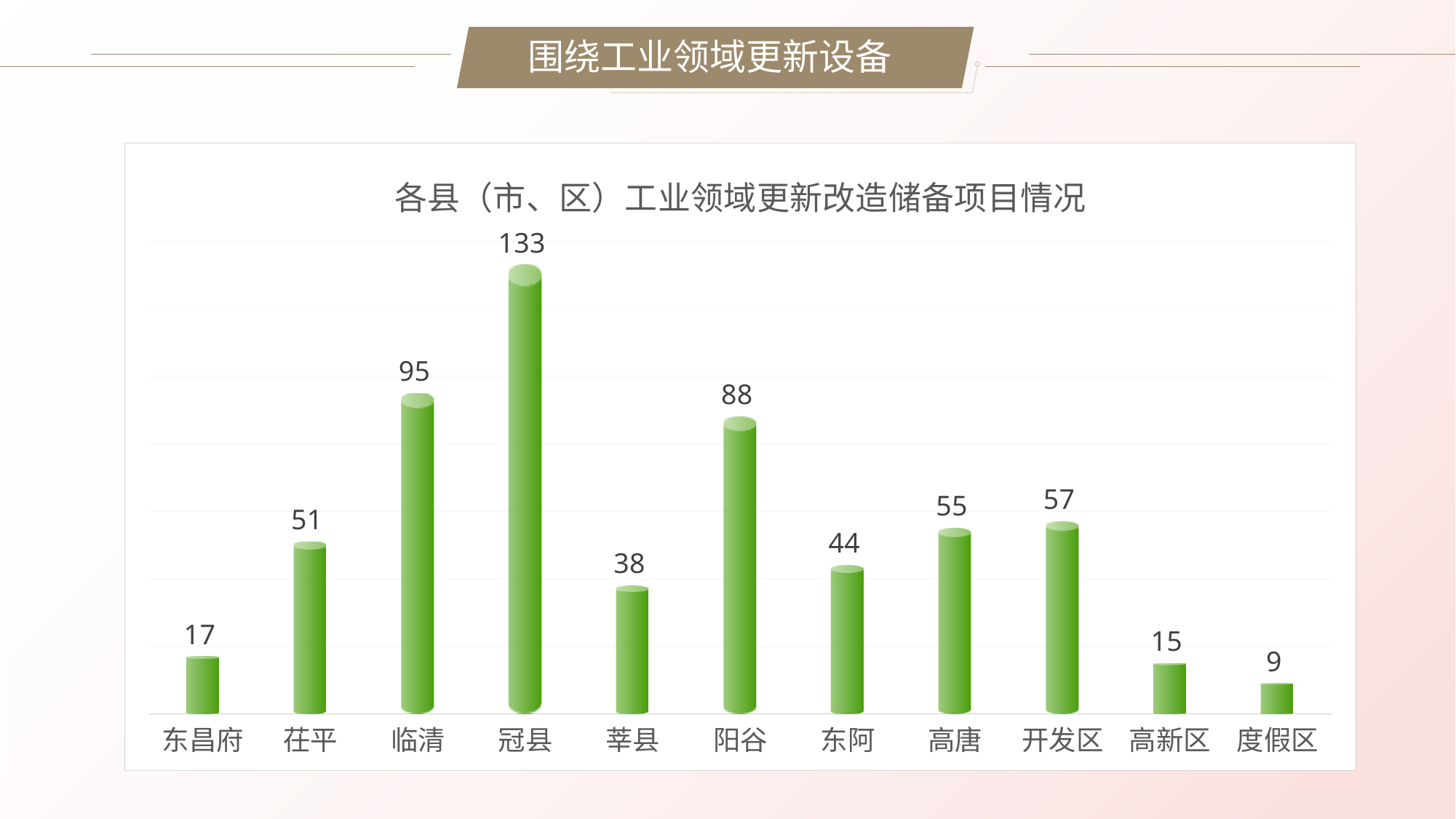
What is the value for 冠县? 133 What is the title of the chart? 各县（市、区）工业领域更新改造储备项目情况 What is the value for 开发区? 57 Which category has the lowest value? 度假区 What kind of chart is shown on the slide? bar chart Which category has the highest value? 冠县 What is the difference between the values for 冠县 and 东昌府? 116 How many categories are shown on the x axis? 11 What is the value for 东昌府? 17 Which is larger, the value for 茌平 or the value for 莘县? 茌平 Which is larger, the value for 高唐 or the value for 东阿? 高唐 What is the difference between the values for 临清 and 阳谷? 7